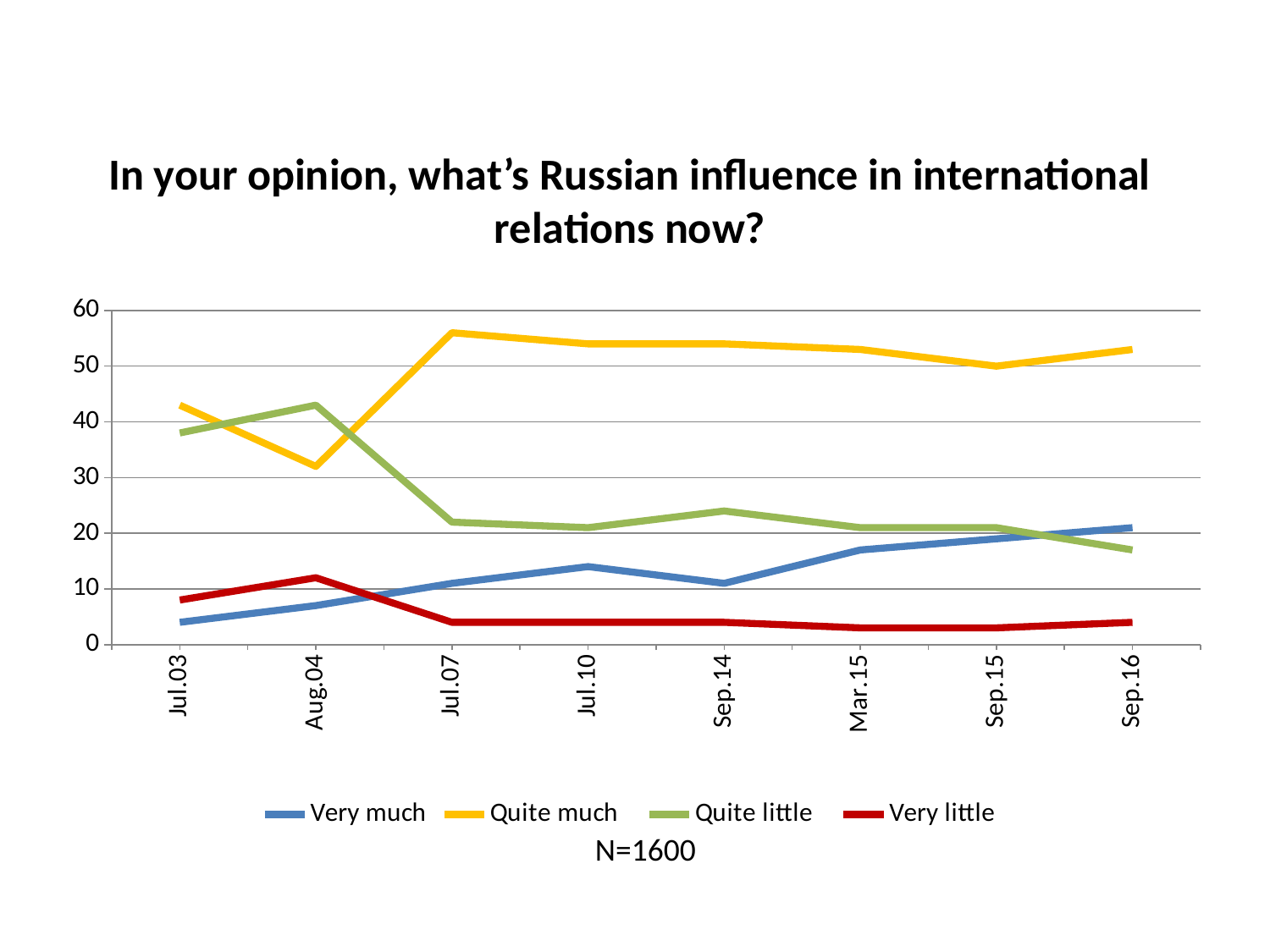
Is the value for 'Quite little' at Aug.04 greater or less than 40? greater Does the 'Quite little' series rise or fall from Aug.04 to Jul.07? fall Which series has the lowest value at Sep.15? Very little How many survey dates are plotted along the x axis? 8 Does the 'Very much' series rise or fall from Jul.03 to Sep.16? rise What sample size is stated below the legend? N=1600 How many series does the legend list? 4 At Sep.16, which is larger: 'Quite much' or 'Quite little'? Quite much Which series has the highest value at Jul.07? Quite much Is the value for 'Quite much' at Jul.07 greater or less than 50? greater What kind of chart is shown on the slide? line chart Is the value for 'Very little' at Jul.03 greater or less than 10? less